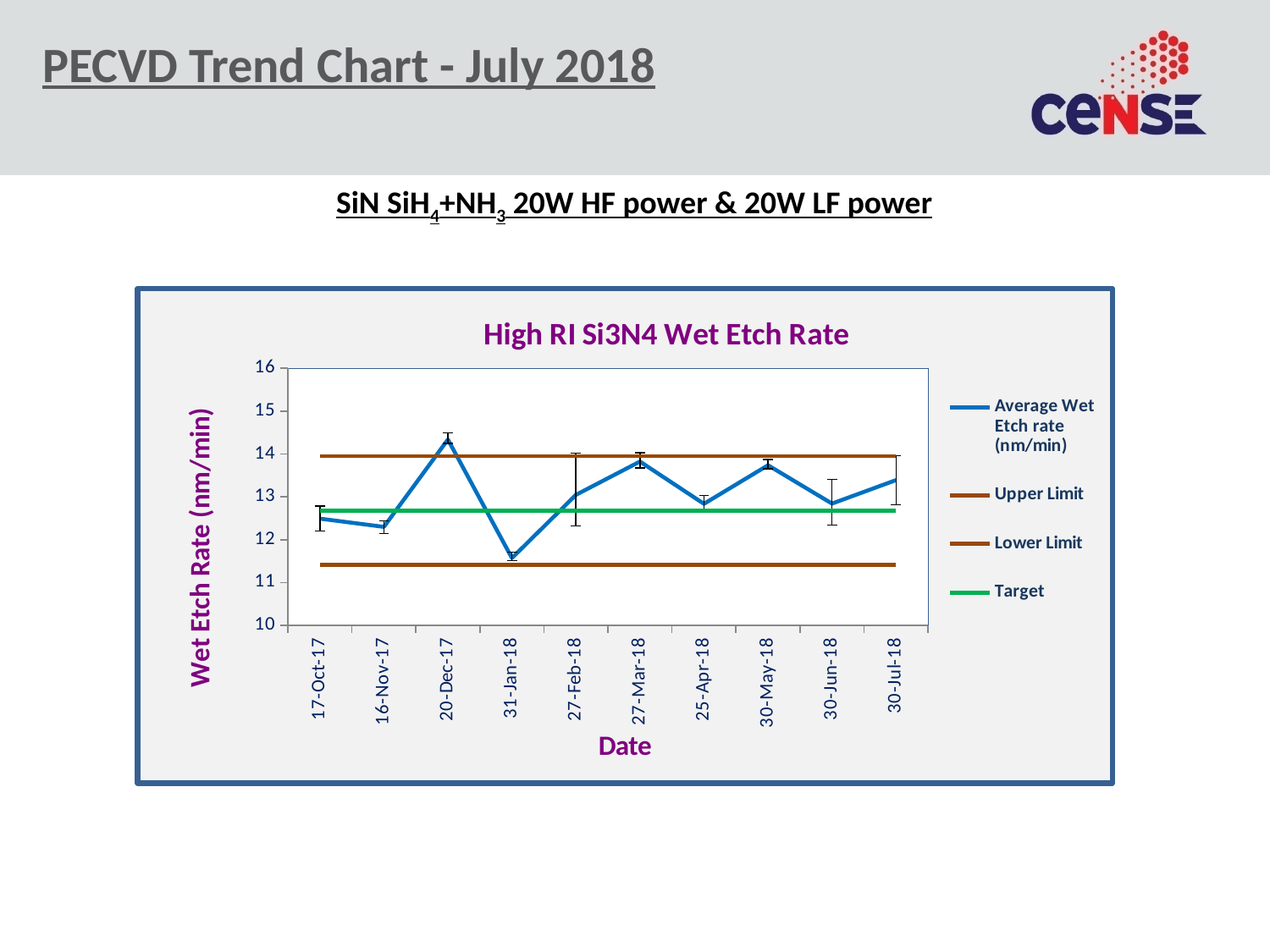
Which has the larger Average Wet Etch rate, 17-Oct-17 or 27-Mar-18? 27-Mar-18 On which date is the Average Wet Etch rate lowest? 31-Jan-18 What is the label of the y axis? Wet Etch Rate (nm/min) How many series does the legend list? 4 Does the Average Wet Etch rate rise or fall from 31-Jan-18 to 27-Mar-18? Rise Is the Average Wet Etch rate for 31-Jan-18 greater or less than 12? less What is the title of the chart? High RI Si3N4 Wet Etch Rate On which date is the Average Wet Etch rate highest? 20-Dec-17 What kind of chart is shown on the slide? Line chart Is the Average Wet Etch rate for 20-Dec-17 greater or less than 14? greater How many dates are plotted along the x axis? 10 Is the Average Wet Etch rate for 16-Nov-17 greater or less than 13? less